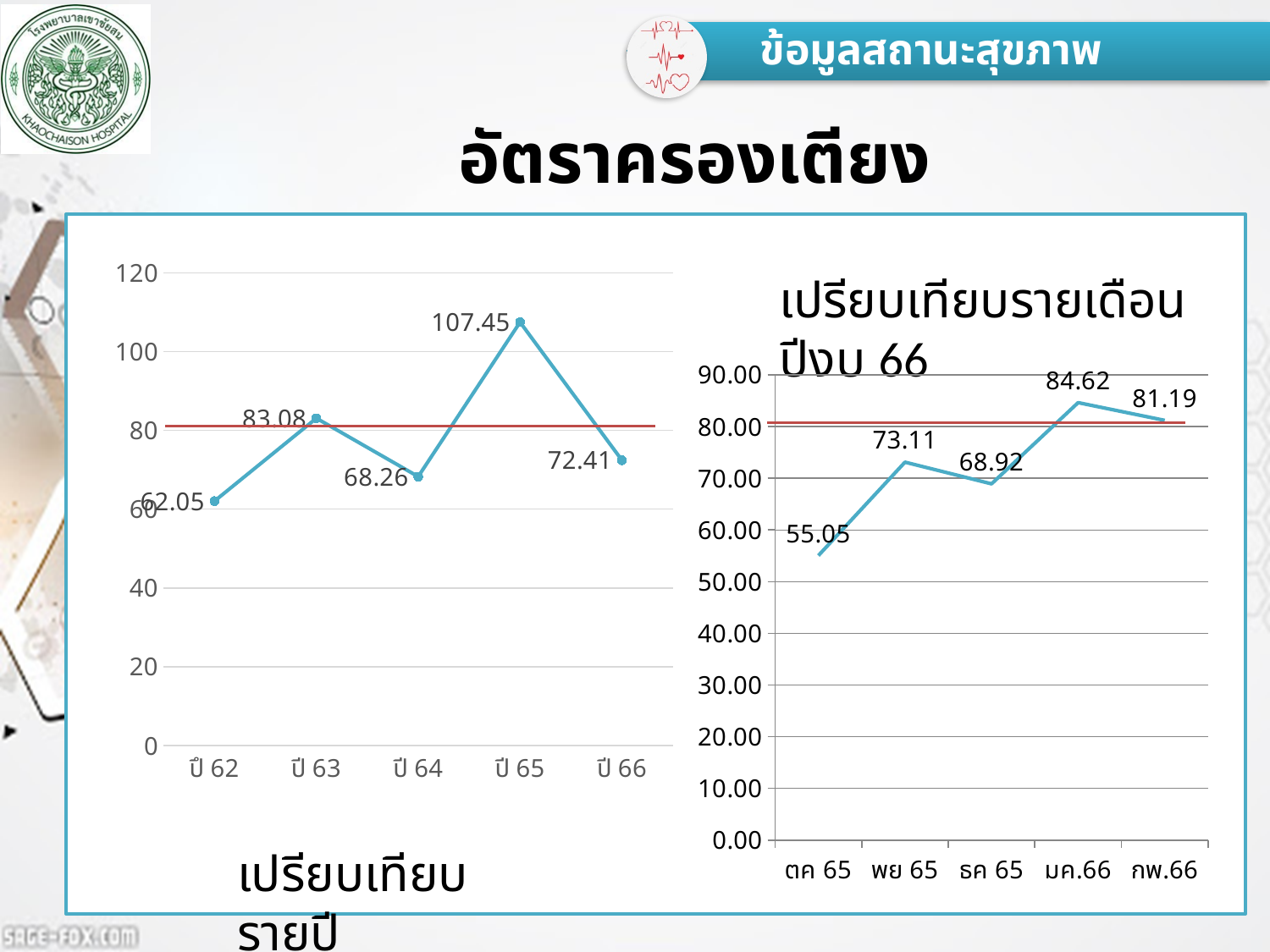
On the right chart (เปรียบเทียบรายเดือน ปีงบ 66), which is larger, the value for พย 65 or ธค 65? พย 65 On the left chart (เปรียบเทียบรายปี), what is the difference between the values for ปี 65 and ปี 66? 35.04 On the right chart (เปรียบเทียบรายเดือน ปีงบ 66), what is the value for มค.66? 84.62 On the left chart (เปรียบเทียบรายปี), what is the value for ปี 62? 62.05 On the left chart (เปรียบเทียบรายปี), which year has the lowest value? ปี 62 On the right chart (เปรียบเทียบรายเดือน ปีงบ 66), what is the value for ตค 65? 55.05 On the left chart (เปรียบเทียบรายปี), how many years are plotted? 5 On the left chart (เปรียบเทียบรายปี), what is the value for ปี 65? 107.45 On the right chart (เปรียบเทียบรายเดือน ปีงบ 66), which month has the lowest value? ตค 65 On the right chart (เปรียบเทียบรายเดือน ปีงบ 66), what is the difference between the values for มค.66 and กพ.66? 3.43 What kind of chart is the right chart (เปรียบเทียบรายเดือน ปีงบ 66)? Line chart On the left chart (เปรียบเทียบรายปี), which year has the highest value? ปี 65